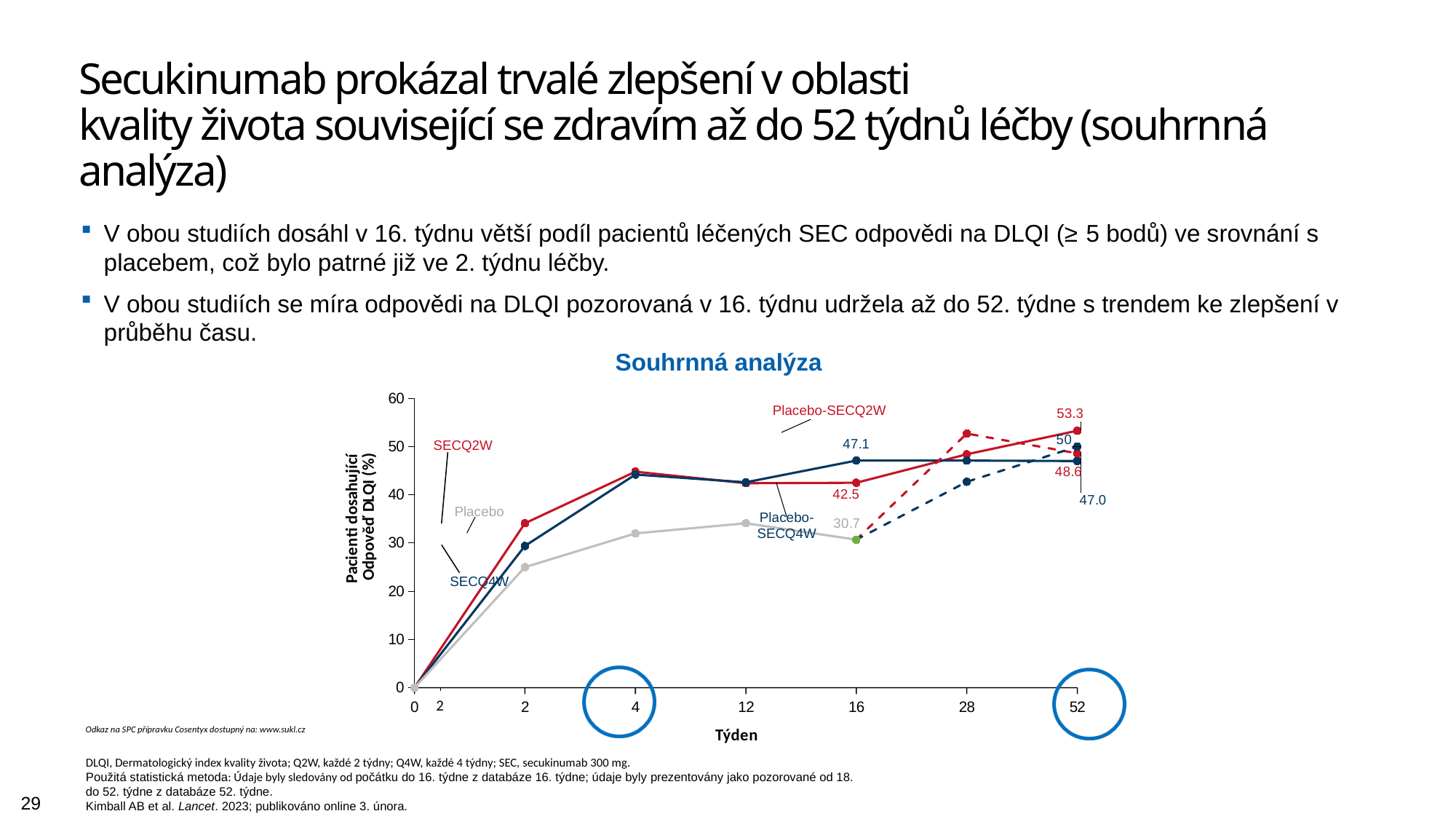
At week 16, which is larger: SECQ4W or Placebo? SECQ4W What is the difference between the SECQ4W and Placebo values at week 16? 16.4 What is the title of the chart? Souhrnná analýza What kind of chart is shown on the slide? line chart What is the value for SECQ2W at week 16? 42.5 What is the value for SECQ4W at week 16? 47.1 Is the value for Placebo at week 12 greater or less than 40? less How many series (lines) are labelled in the chart? 5 What is the label of the x axis of the chart? Týden What is the value for Placebo at week 16? 30.7 What is the difference between the SECQ4W and SECQ2W values at week 16? 4.6 Which series has the highest value at week 52? SECQ2W